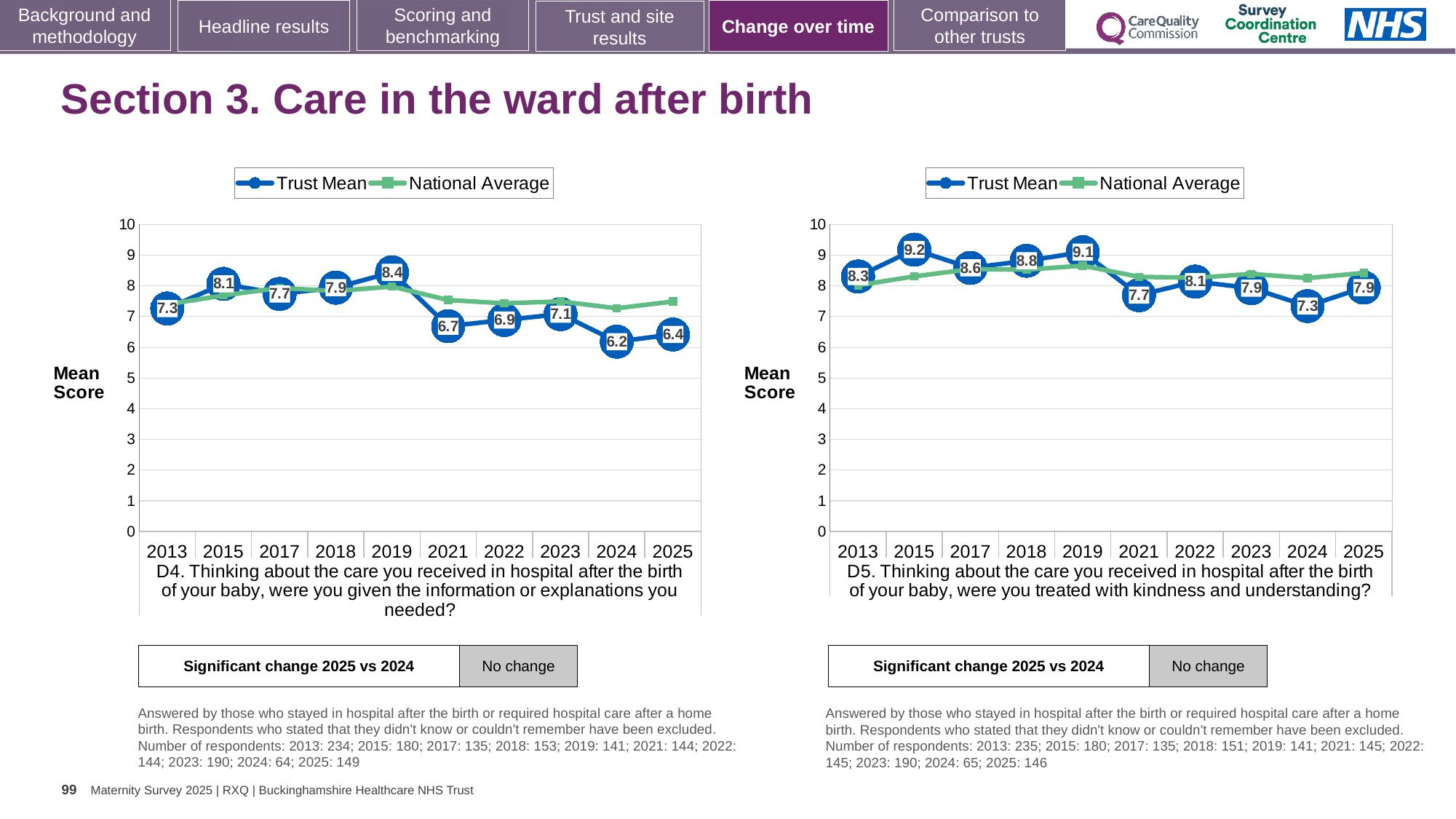
In the left chart (D4), what is the Trust Mean score for 2019? 8.4 In the right chart (D5), which is larger, the Trust Mean score for 2018 or for 2021? 2018 In the right chart (D5), what is the Trust Mean score for 2024? 7.3 In the left chart (D4), which year has the lowest Trust Mean score? 2024 How many series does the legend of the right chart (D5) list? 2 In the left chart (D4), is the National Average value for 2025 greater or less than 7? greater In the left chart (D4), what is the difference between the Trust Mean scores for 2019 and 2025? 2.0 In the right chart (D5), what is the difference between the Trust Mean scores for 2015 and 2024? 1.9 In the right chart (D5), is the National Average value for 2025 greater or less than 8? greater In the right chart (D5), which year has the highest Trust Mean score? 2015 How many years are plotted on the x axis of the left chart (D4)? 10 What kind of chart is the left chart (D4)? Line chart